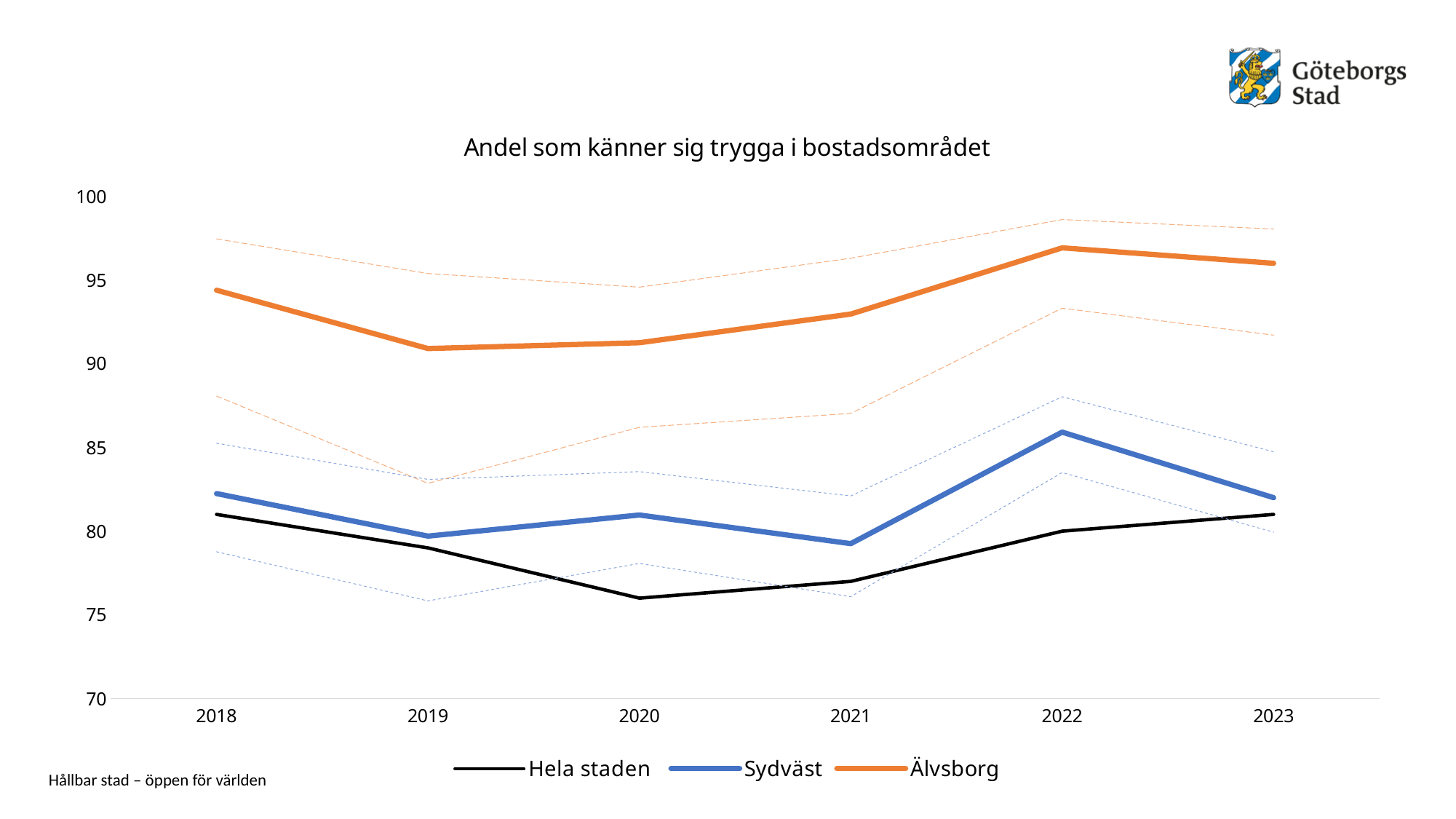
Is the value for Älvsborg in 2018 greater or less than 90? greater What is the title of the chart? Andel som känner sig trygga i bostadsområdet Does the Älvsborg line rise or fall from 2019 to 2022? Rise Which series is drawn in orange? Älvsborg How many years are shown on the x axis? 6 How many series does the legend list? 3 What kind of chart is shown on the slide? Line chart In which year does Sydväst reach its highest value? 2022 Which series has the higher value in 2020, Hela staden or Sydväst? Sydväst Is the value for Älvsborg in 2022 greater or less than 95? greater Is the value for Hela staden in 2020 greater or less than 80? less In which year does Hela staden have its lowest value? 2020